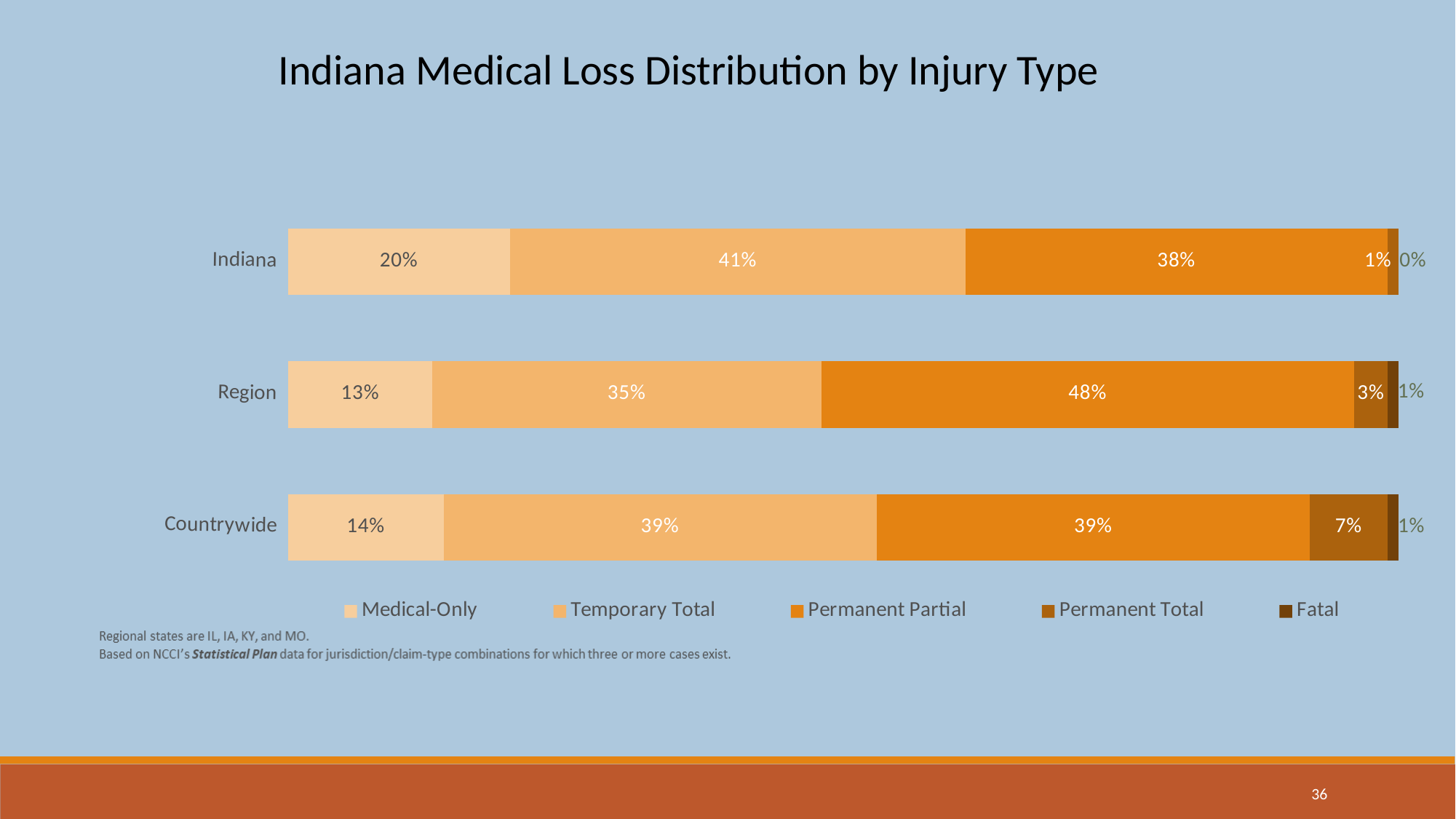
Which category has the highest Medical-Only share? Indiana How many series does the legend list? 5 How many categories are shown on the chart? 3 What is the difference between the Permanent Partial shares for Region and Indiana? 10% Which category has the lowest Permanent Partial share? Indiana Which is larger, the Temporary Total share for Indiana or for Region? Indiana What is the Temporary Total share for Indiana? 41% What is the Permanent Total share for Countrywide? 7% What is the title of the chart? Indiana Medical Loss Distribution by Injury Type What kind of chart is shown on the slide? Stacked bar chart What is the Permanent Partial share for Region? 48% What is the Medical-Only share for Region? 13%